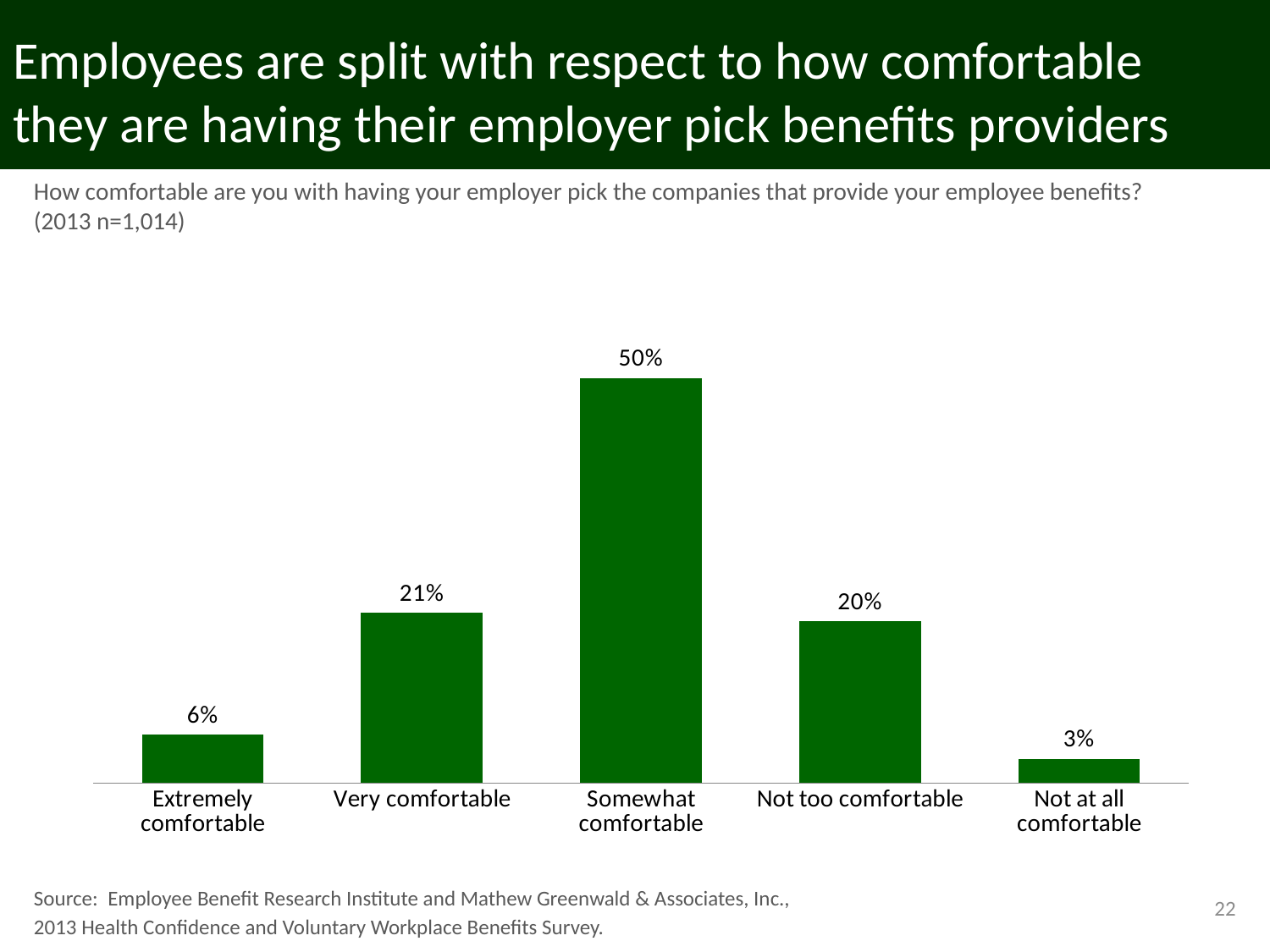
Which response category has the highest percentage? Somewhat comfortable What type of chart is shown on the slide? Bar chart Which is larger, the percentage for 'Extremely comfortable' or for 'Not at all comfortable'? Extremely comfortable What is the difference in percentage points between 'Somewhat comfortable' and 'Not too comfortable'? 30 percentage points What is the sample size (n) shown for the 2013 survey question on the slide? 1,014 What percentage of employees said they are very comfortable? 21% What percentage of employees said they are not at all comfortable? 3% What is the difference in percentage points between 'Very comfortable' and 'Extremely comfortable'? 15 percentage points What percentage of employees said they are somewhat comfortable with having their employer pick the companies that provide their benefits? 50% Which response category has the lowest percentage? Not at all comfortable How many response categories are shown in the chart? 5 What percentage of employees said they are extremely comfortable? 6%